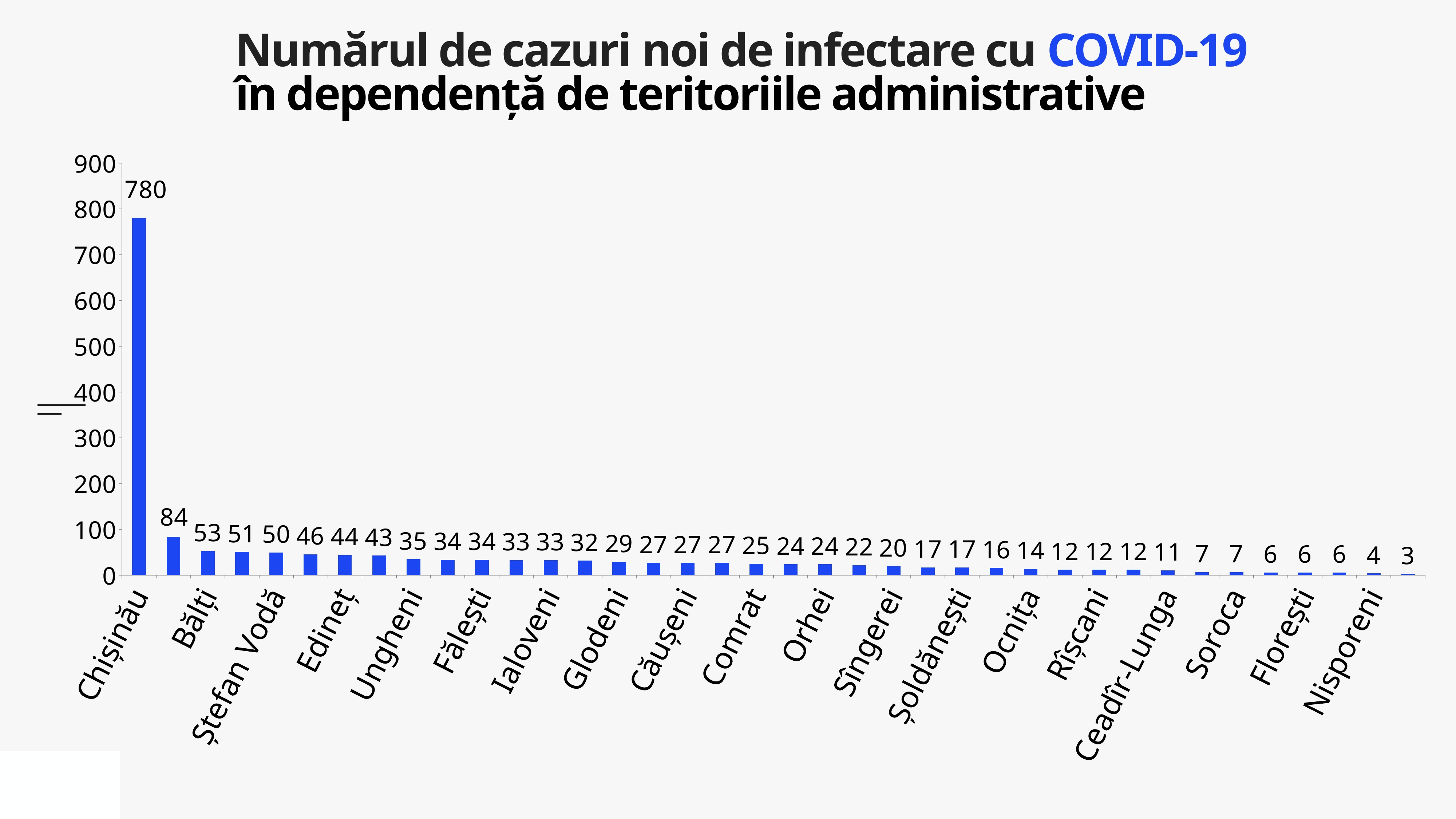
What is the title of the chart? Numărul de cazuri noi de infectare cu COVID-19 în dependență de teritoriile administrative Do the values rise or fall from left to right along the x axis? fall What kind of chart is shown on the slide? bar chart What is the highest tick value shown on the y axis? 900 Which is larger, the value for Chișinău or the value for Bălți? Chișinău What is the value for Chișinău? 780 Is the value for Chișinău greater or less than 700? greater What is the smallest data label shown in the chart? 3 How many bars exceed 100 on the y axis? 1 How many bars are plotted in the chart? 38 Which territory has the highest number of new cases? Chișinău